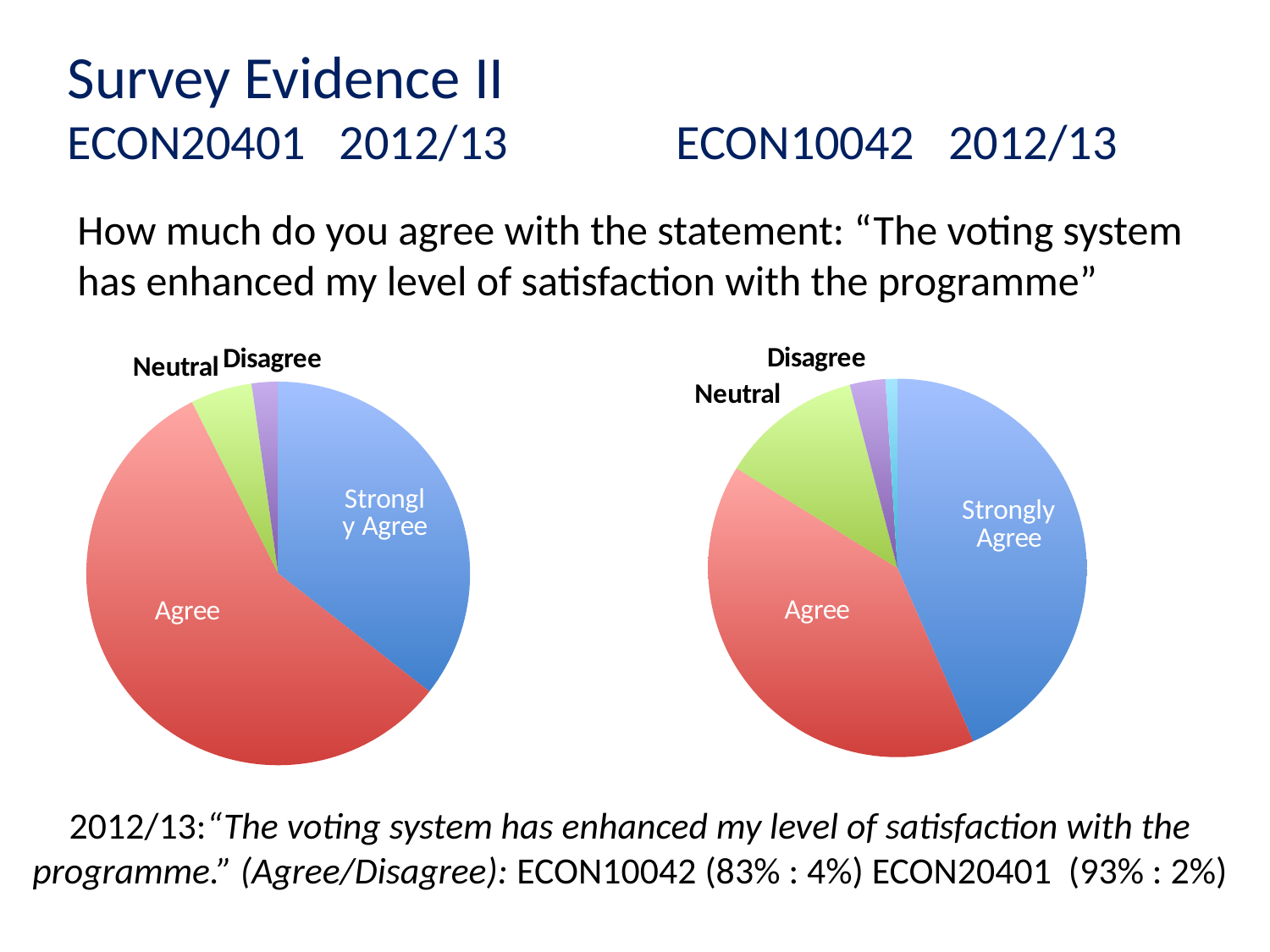
Is the Neutral slice larger in the left pie chart (ECON20401) or the right pie chart (ECON10042)? Right (ECON10042) How many pie charts are shown on the slide? 2 In the left pie chart (ECON20401 2012/13), which slice is larger, Neutral or Disagree? Neutral In the left pie chart (ECON20401 2012/13), which slice is larger, Agree or Strongly Agree? Agree What kind of chart is used on the left (ECON20401 2012/13) side of the slide? Pie chart What colour is the Agree slice in both pie charts? Red How many labelled slices does the left pie chart (ECON20401 2012/13) have? 4 What colour is the Strongly Agree slice in both pie charts? Blue In the left pie chart (ECON20401 2012/13), which labelled response category has the smallest slice? Disagree In the left pie chart (ECON20401 2012/13), which response category has the largest slice? Agree